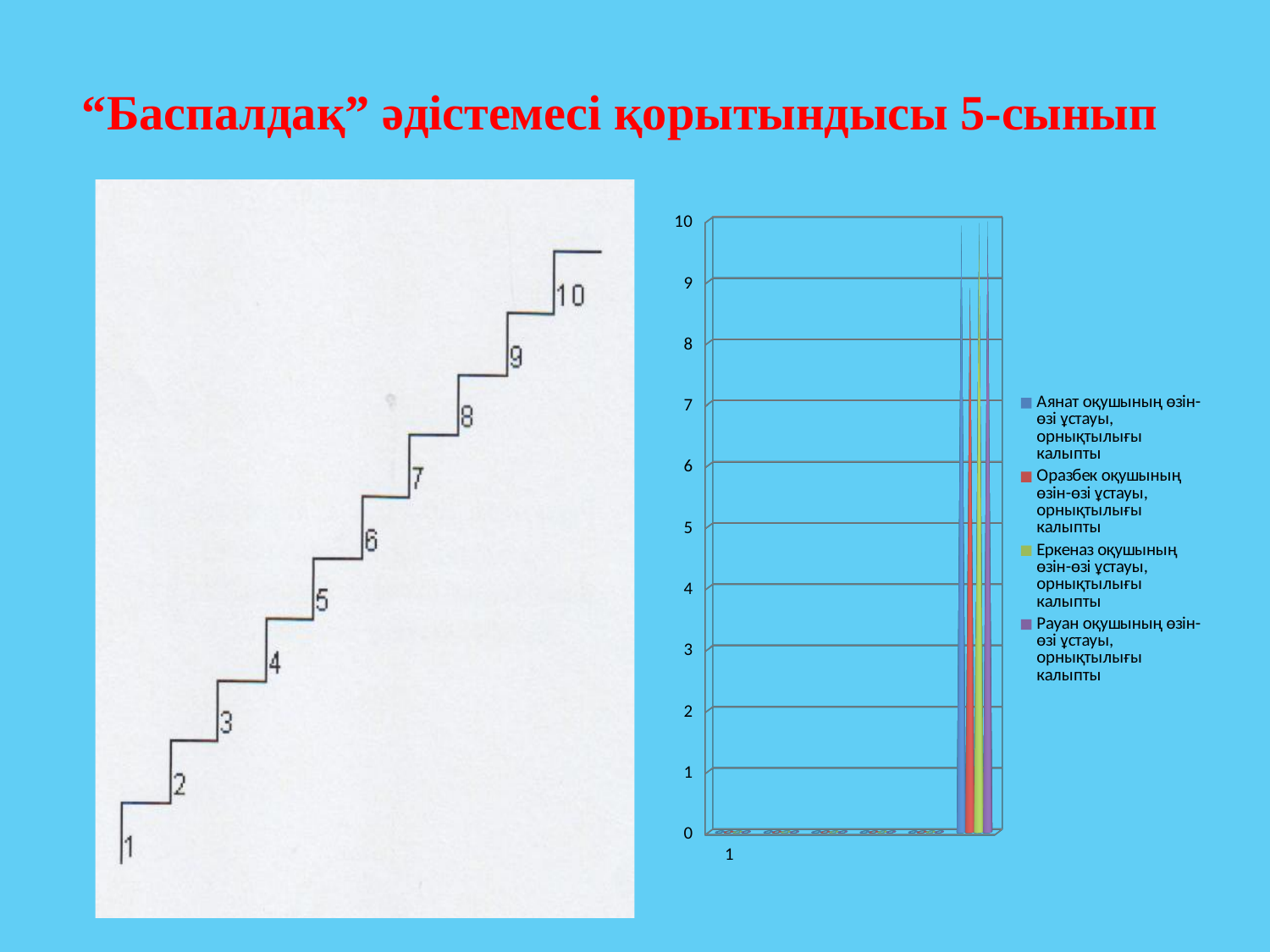
In the bar chart, is the value for Рауан оқушының өзін-өзі ұстауы, орнықтылығы калыпты greater or less than 6? greater What kind of chart is shown on the right side of the slide? bar chart In the bar chart, is the value for Еркеназ оқушының өзін-өзі ұстауы, орнықтылығы калыпты greater or less than 4? greater How many categories are shown on the x axis of the bar chart? 1 What is the category label on the x axis of the bar chart? 1 In the bar chart, is the value for Оразбек оқушының өзін-өзі ұстауы, орнықтылығы калыпты greater or less than 5? greater How many series does the legend of the bar chart list? 4 What is the highest value shown on the y axis of the bar chart? 10